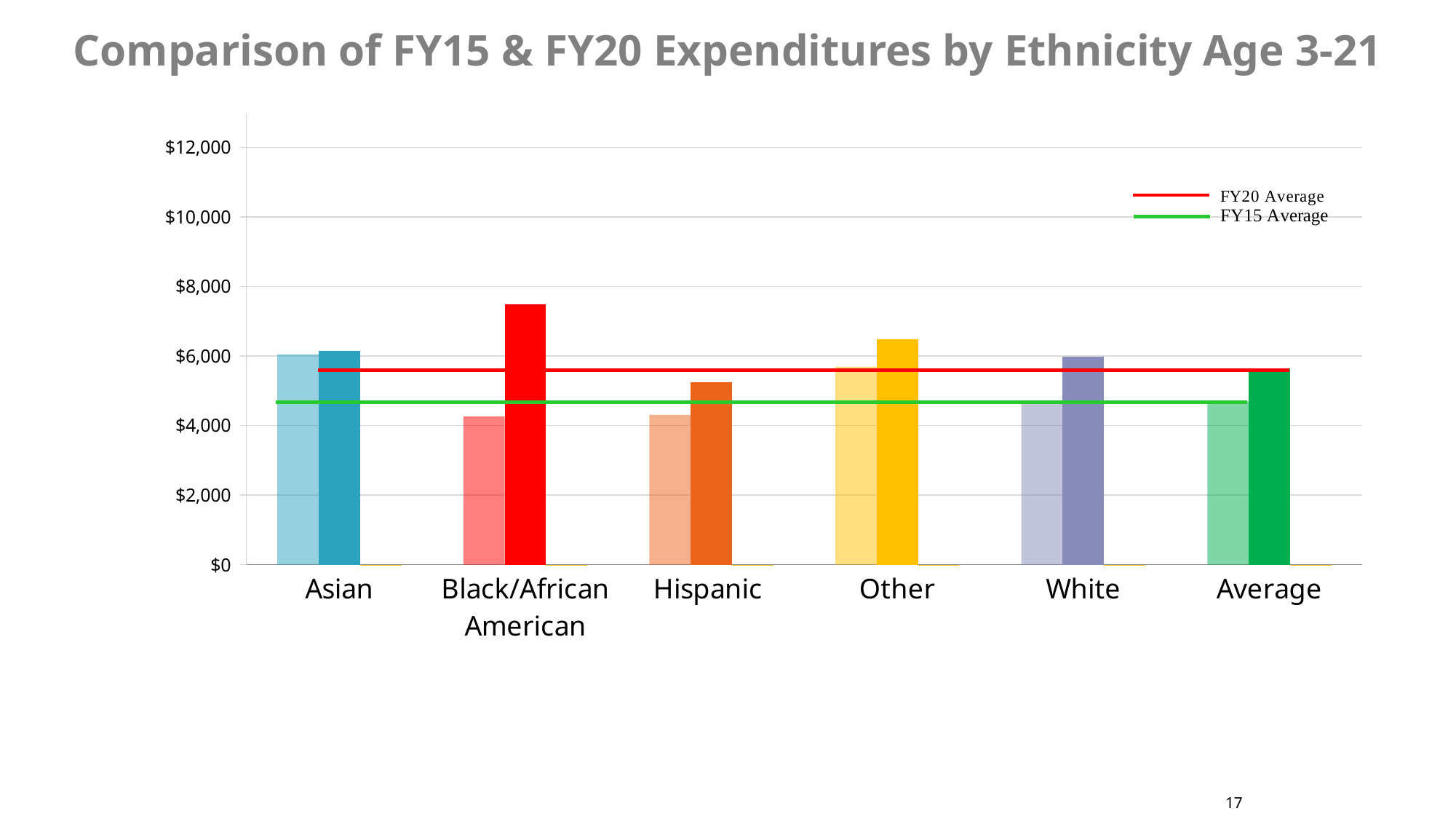
Is the value of the taller (darker) bar for Other greater or less than $6,000? greater Which is larger: the darker bar for Black/African American or the darker bar for Hispanic? Black/African American Is the value of the shorter (lighter) bar for White greater or less than $6,000? less Which category has the tallest bar in the chart? Black/African American What kind of chart is shown on the slide? bar chart Which is larger: the darker bar for Other or the darker bar for White? Other How many entries does the legend list? 2 Which legend entry is drawn as a red line? FY20 Average What is the title of the chart? Comparison of FY15 & FY20 Expenditures by Ethnicity Age 3-21 Is the value of the taller (darker) bar for Black/African American greater or less than $6,000? greater How many categories are shown along the x axis? 6